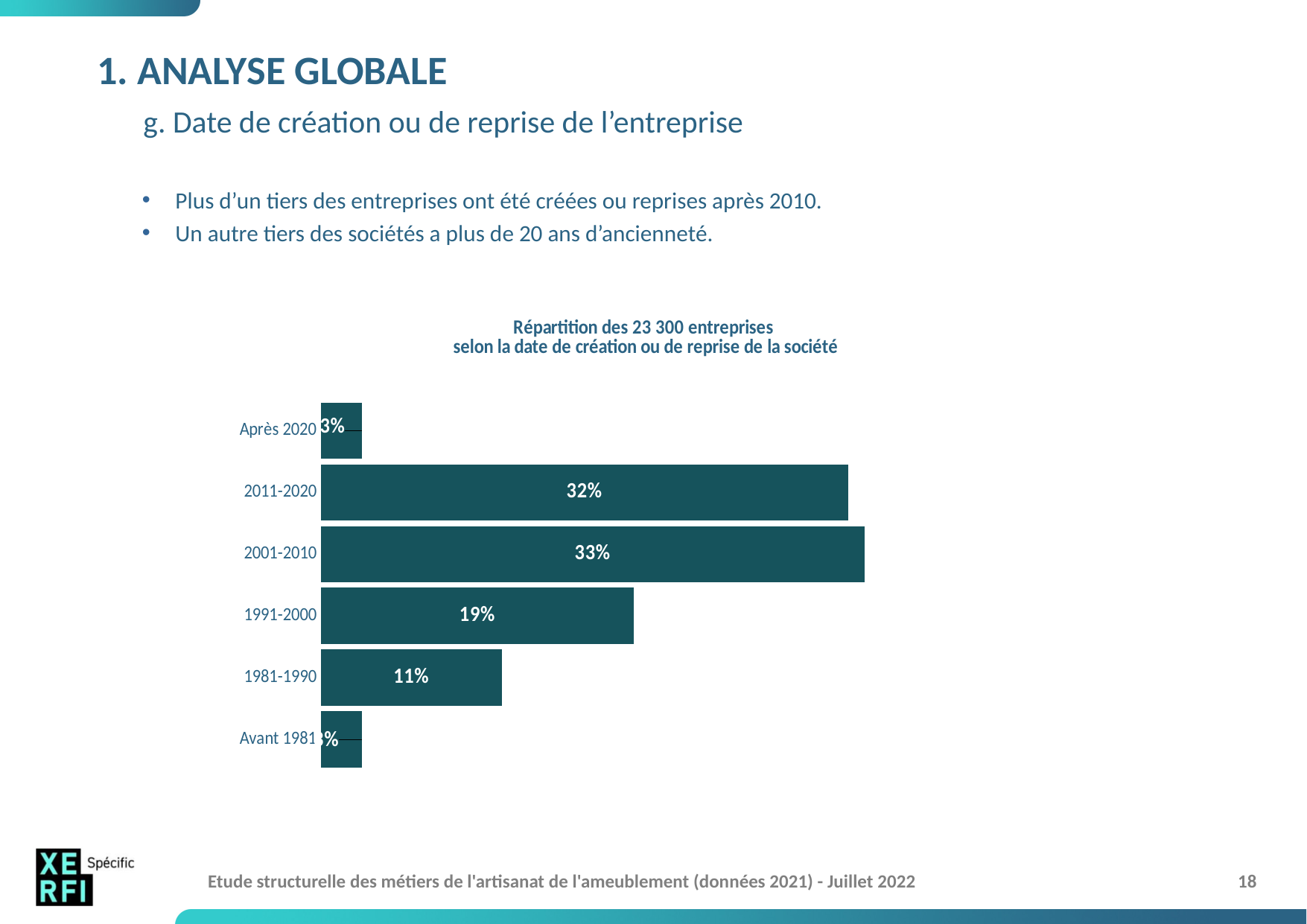
What is the difference between the 1991-2000 and 1981-1990 values? 8 percentage points What is the value for the 1981-1990 category? 11% How many time-period categories are shown in the chart? 6 How many enterprises does the chart title say are covered by the distribution? 23 300 What is the value shown for the 2001-2010 category? 33% Which is larger, the value for 1991-2000 or the value for 1981-1990? 1991-2000 What percentage of the enterprises were created or taken over in 2011-2020? 32% What type of chart is used on this slide? Bar chart Which period has the highest share of enterprises? 2001-2010 What share of enterprises falls in the 1991-2000 period? 19% What percentage is shown for 'Après 2020'? 3% What is the difference in percentage points between the 2001-2010 and 2011-2020 categories? 1 percentage point